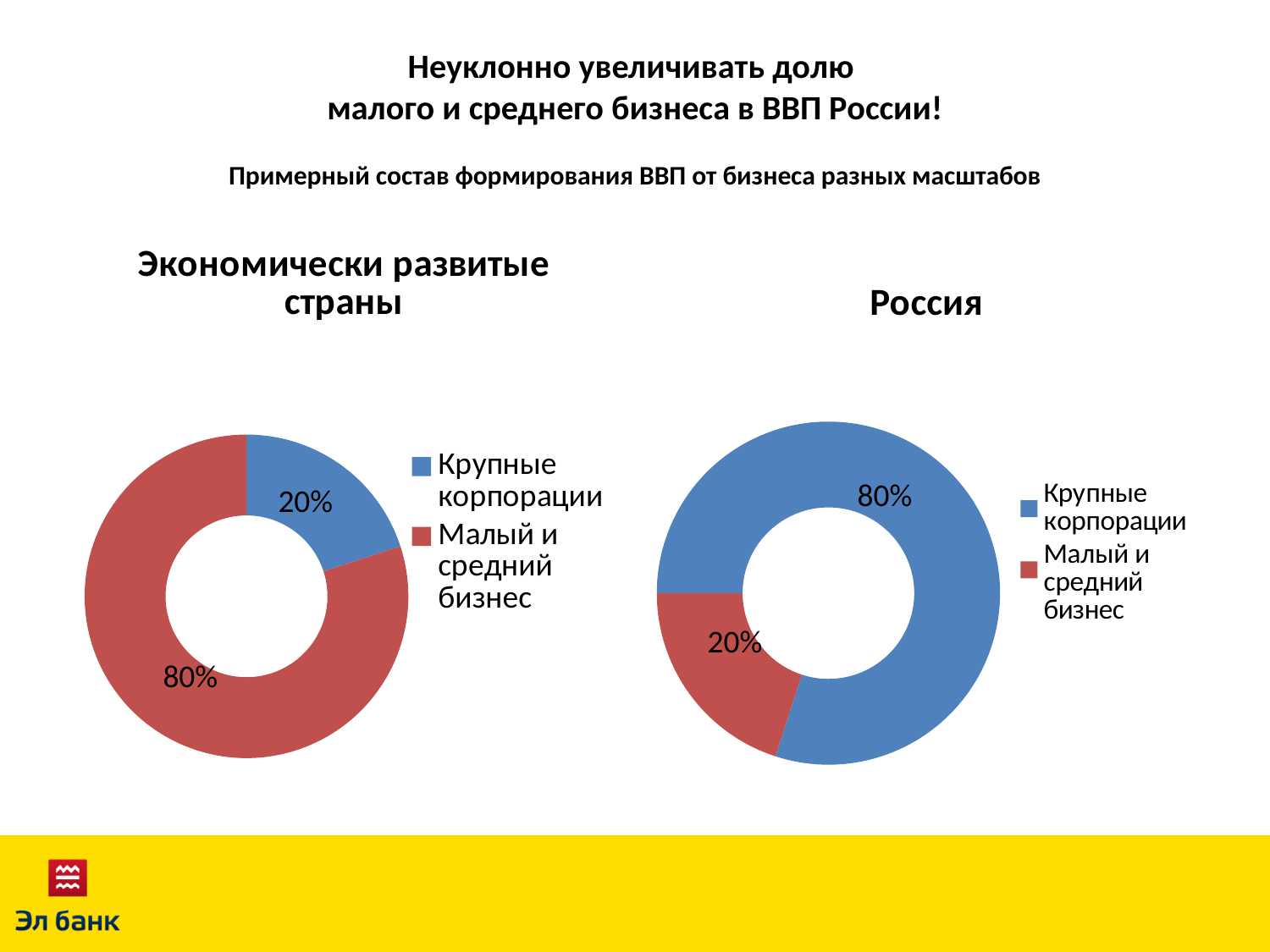
In the "Экономически развитые страны" chart, which category has the smallest share? Крупные корпорации What is the title of the chart on the right side of the slide? Россия In the "Экономически развитые страны" chart, what share is labelled for Крупные корпорации? 20% In the "Россия" chart, which category has the largest share? Крупные корпорации In the "Россия" chart, what is the difference between the share of Крупные корпорации and the share of Малый и средний бизнес? 60% In the "Россия" chart, what share is labelled for Крупные корпорации? 80% In the "Россия" chart, what colour represents Малый и средний бизнес? Red In the "Экономически развитые страны" chart, what share is labelled for Малый и средний бизнес? 80% What kind of chart is the "Экономически развитые страны" chart? Doughnut chart How many categories does the "Россия" chart show? 2 In the "Россия" chart, what share is labelled for Малый и средний бизнес? 20% In the "Экономически развитые страны" chart, which is larger: Крупные корпорации or Малый и средний бизнес? Малый и средний бизнес